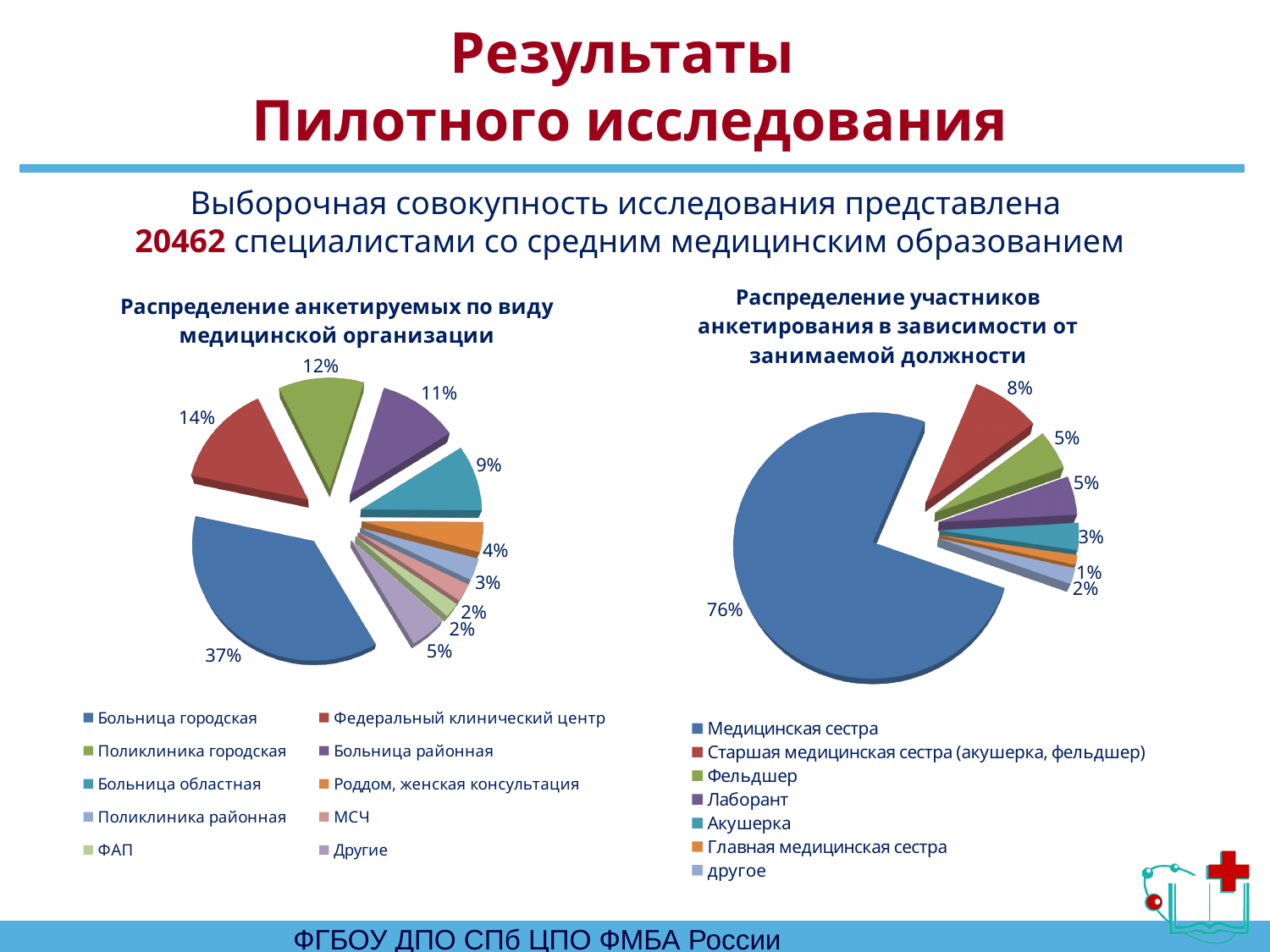
In the left pie chart (Распределение анкетируемых по виду медицинской организации), how many categories does the legend list? 10 In the left pie chart (Распределение анкетируемых по виду медицинской организации), which category has the largest share? Больница городская In the left pie chart (Распределение анкетируемых по виду медицинской организации), which is larger: the share for Больница районная or the share for Роддом, женская консультация? Больница районная In the right pie chart (Распределение участников анкетирования в зависимости от занимаемой должности), what is the difference between the shares of Медицинская сестра and Старшая медицинская сестра (акушерка, фельдшер)? 68% In the right pie chart (Распределение участников анкетирования в зависимости от занимаемой должности), what share is shown for Старшая медицинская сестра (акушерка, фельдшер)? 8% In the left pie chart (Распределение анкетируемых по виду медицинской организации), what share is shown for Больница городская? 37% In the right pie chart (Распределение участников анкетирования в зависимости от занимаемой должности), how many categories does the legend list? 7 In the right pie chart (Распределение участников анкетирования в зависимости от занимаемой должности), what share is shown for Медицинская сестра? 76% In the left pie chart (Распределение анкетируемых по виду медицинской организации), what share is shown for Федеральный клинический центр? 14% In the left pie chart (Распределение анкетируемых по виду медицинской организации), what is the difference between the shares of Поликлиника городская and Больница областная? 3% What type of chart is used on the right side of the slide (Распределение участников анкетирования в зависимости от занимаемой должности)? Pie chart In the right pie chart (Распределение участников анкетирования в зависимости от занимаемой должности), which category has the smallest share? Главная медицинская сестра